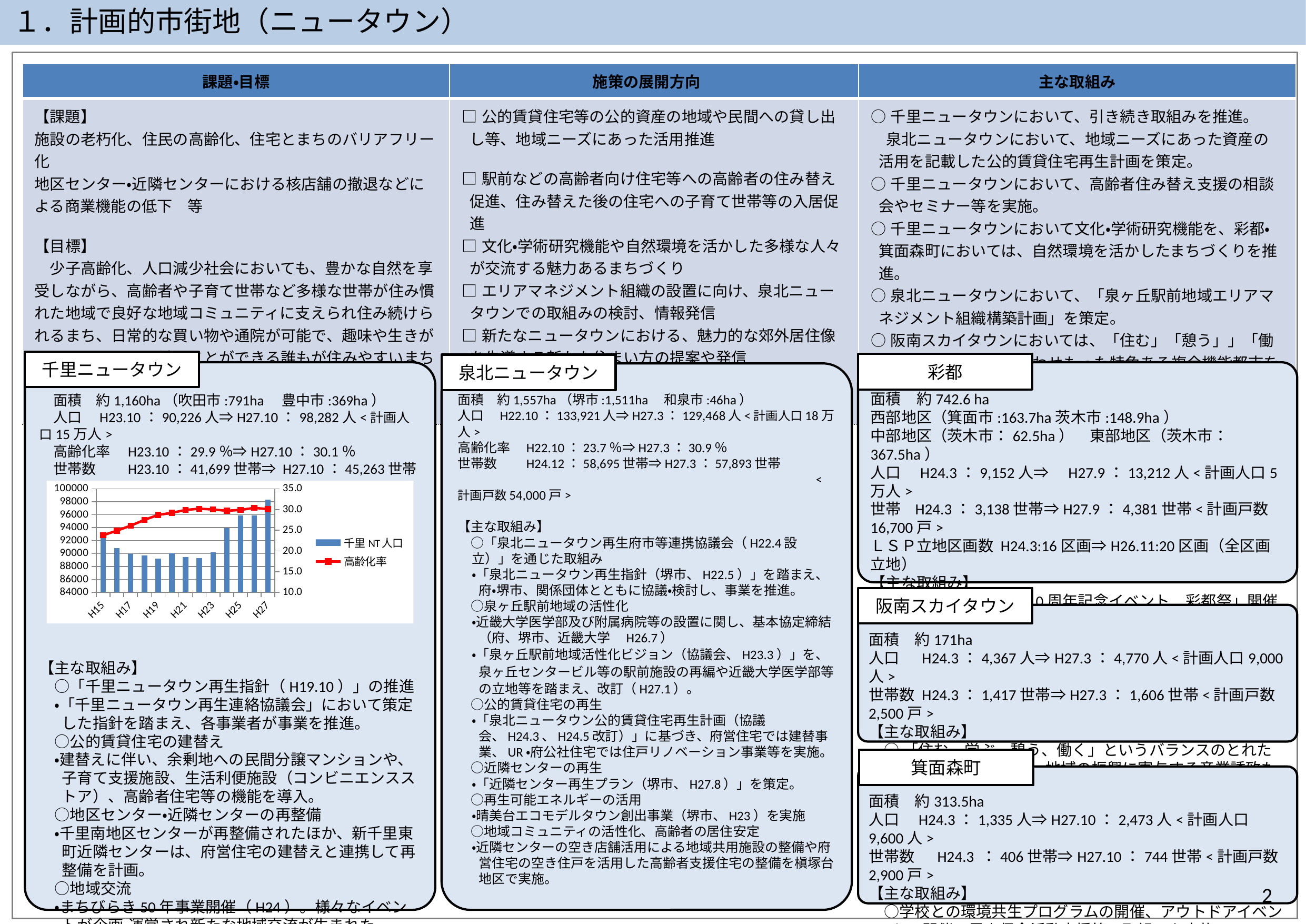
In the 千里ニュータウン chart, is the 千里NT人口 value for H15 greater or less than 90000? greater What kind of chart is shown in the 千里ニュータウン section? A combined bar and line chart In the 千里ニュータウン chart, does the 高齢化率 line generally rise or fall from H15 to H27? rise In the 千里ニュータウン chart, is the 高齢化率 value for H27 greater or less than 25.0? greater How many series does the legend of the chart in the 千里ニュータウン section list? 2 In the 千里ニュータウン chart, is the 高齢化率 value for H15 greater or less than 20.0? greater How many bars (years) are plotted in the 千里ニュータウン chart? 13 In the 千里ニュータウン chart, which year has the highest 千里NT人口 bar? H27 In the 千里ニュータウン chart, which is larger, the 千里NT人口 bar for H27 or for H15? H27 What are the two legend entries of the chart in the 千里ニュータウン section? 千里NT人口 and 高齢化率